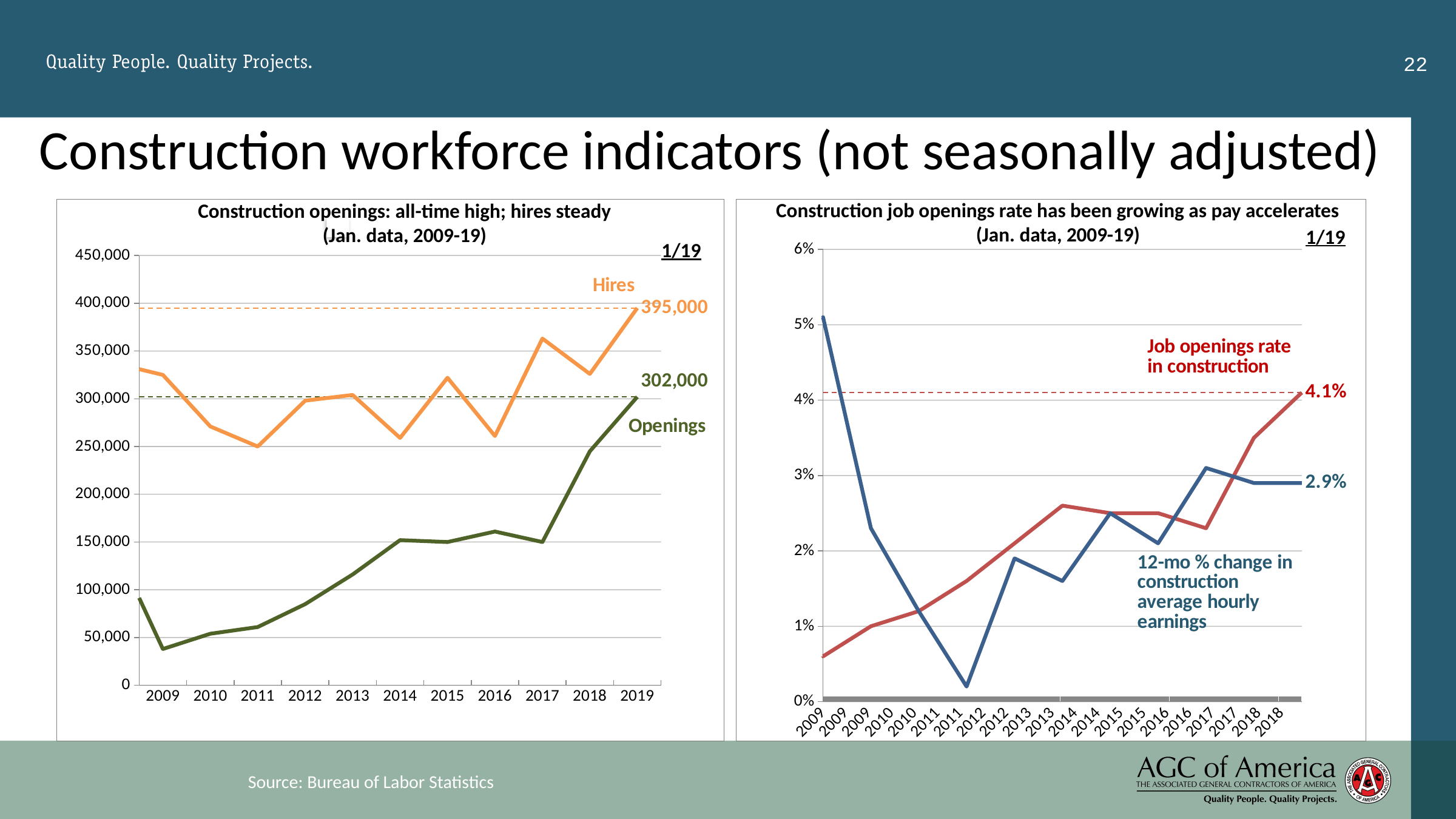
In the left chart, which is larger in 1/19: Hires or Openings? Hires In the left chart, is the Openings value for 2009 greater or less than 100,000? less In the left chart, what is the difference between the 1/19 Hires value and the 1/19 Openings value? 93,000 In the left chart (Construction openings: all-time high; hires steady), what is the value of Openings for 1/19? 302,000 In the right chart, what is the job openings rate in construction for 1/19? 4.1% In the right chart, what is the 12-mo % change in construction average hourly earnings for 1/19? 2.9% In the left chart, does the Openings line rise or fall from 2017 to 2019? rise In the left chart, how many years are shown on the x axis? 11 What kind of chart is the right chart (Construction job openings rate has been growing as pay accelerates)? line chart In the left chart (Construction openings: all-time high; hires steady), what is the value of Hires for 1/19? 395,000 In the left chart, is the Hires value for 2011 greater or less than 300,000? less In the right chart, is the 12-mo % change in construction average hourly earnings for 2009 greater or less than 4%? greater